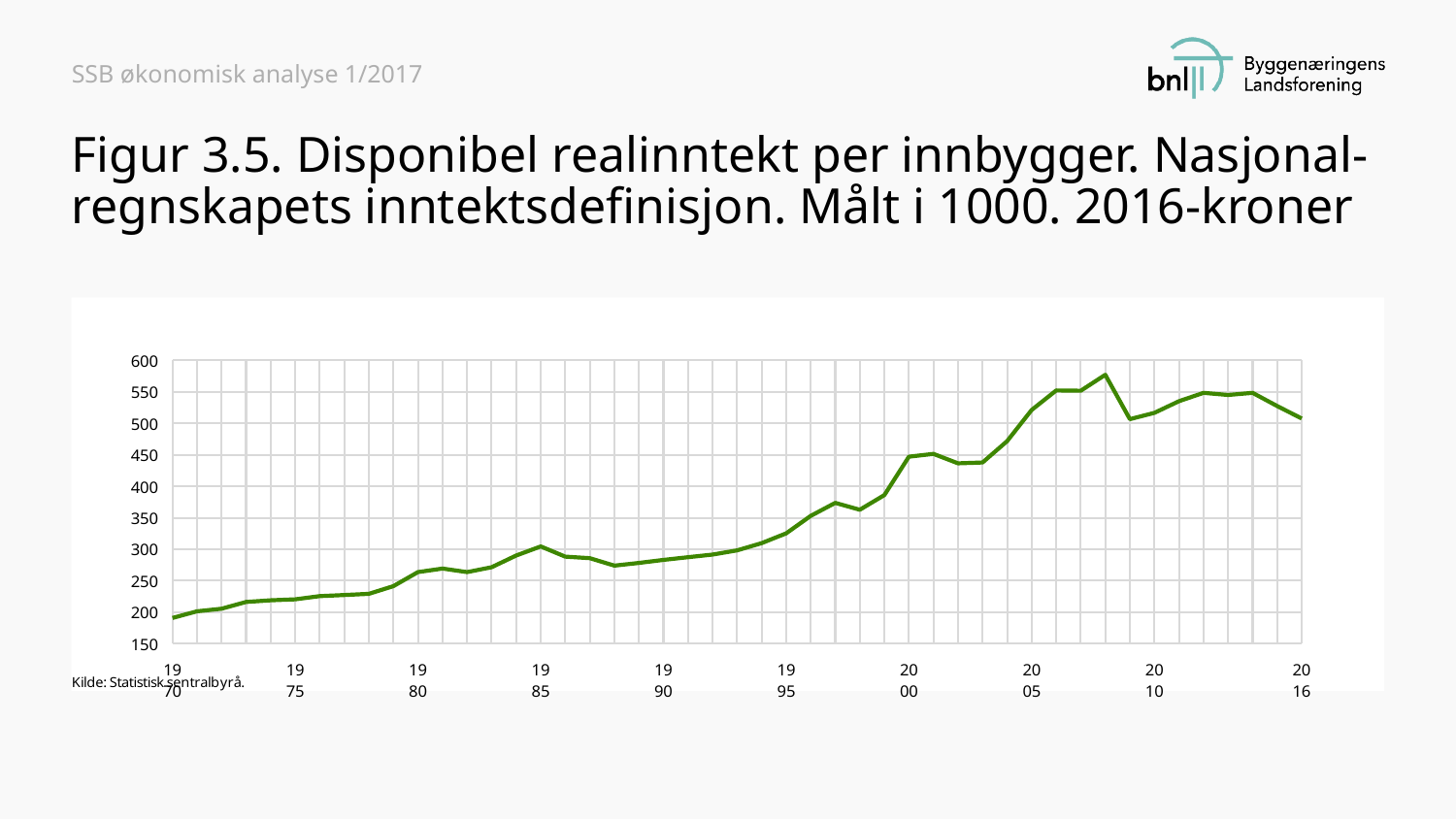
Is the value for 2000 greater or less than 400? greater Is the value for 1970 greater or less than 250? less Which year has the higher value, 2000 or 2016? 2016 What kind of chart is shown on the slide? line chart Is the value for 1985 greater or less than 250? greater What source is cited below the chart? Statistisk sentralbyrå Overall, do the values rise or fall from 1970 to 2016? rise In which year is the value lowest? 1970 Which year has the higher value, 1995 or 2000? 2000